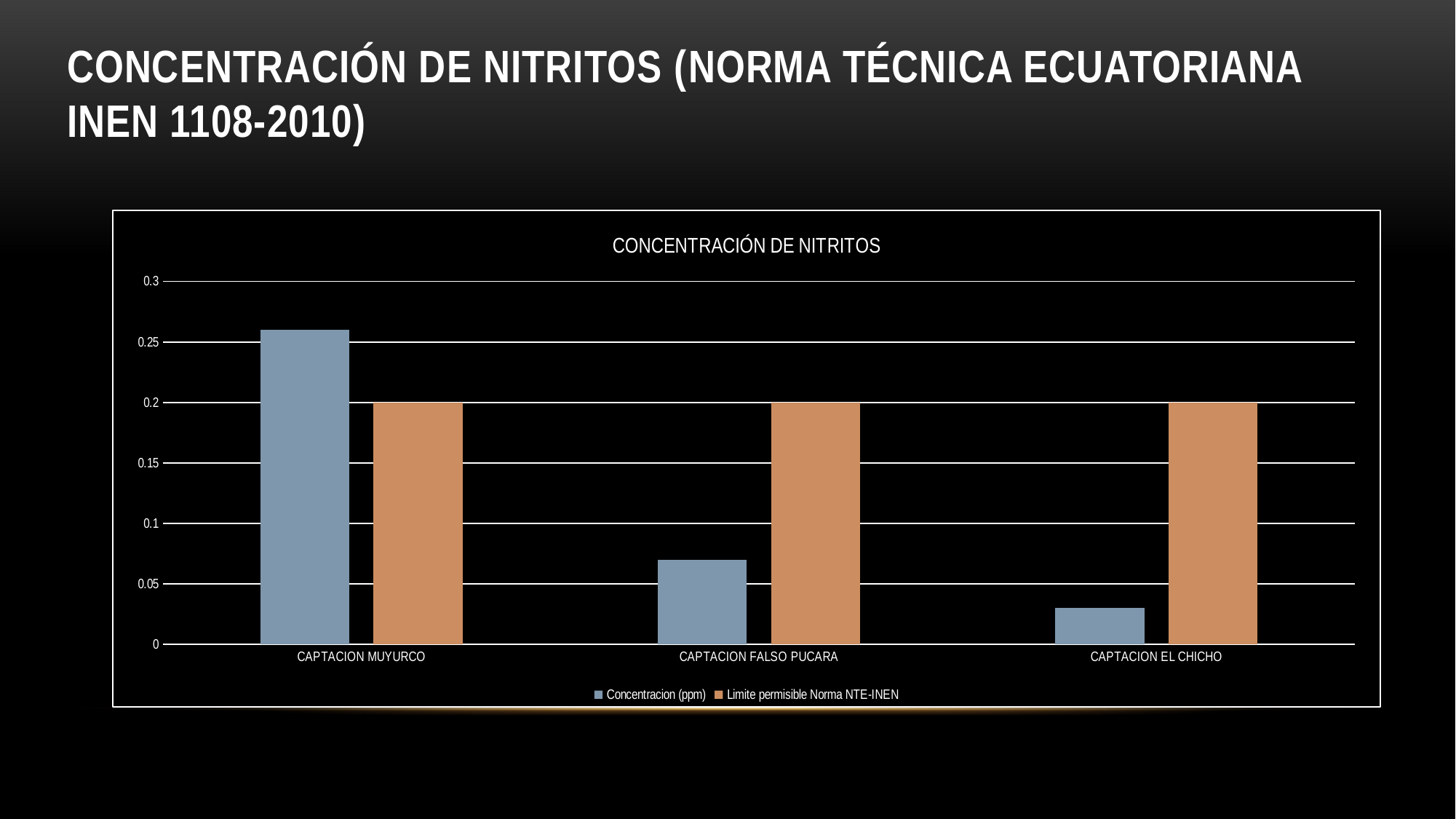
Which category has the lowest Concentracion (ppm)? CAPTACION EL CHICHO For CAPTACION MUYURCO, which is larger: Concentracion (ppm) or Limite permisible Norma NTE-INEN? Concentracion (ppm) How many categories are shown on the x axis? 3 What type of chart is shown on the slide? bar chart What is the value of Limite permisible Norma NTE-INEN for CAPTACION MUYURCO? 0.2 Is the Concentracion (ppm) for CAPTACION FALSO PUCARA greater or less than 0.1? less What is the value of Limite permisible Norma NTE-INEN for CAPTACION EL CHICHO? 0.2 How many series does the legend list? 2 Is the Concentracion (ppm) for CAPTACION MUYURCO greater or less than 0.25? greater Is the Concentracion (ppm) for CAPTACION EL CHICHO greater or less than 0.05? less What is the title of the chart? CONCENTRACIÓN DE NITRITOS Which category has the highest Concentracion (ppm)? CAPTACION MUYURCO